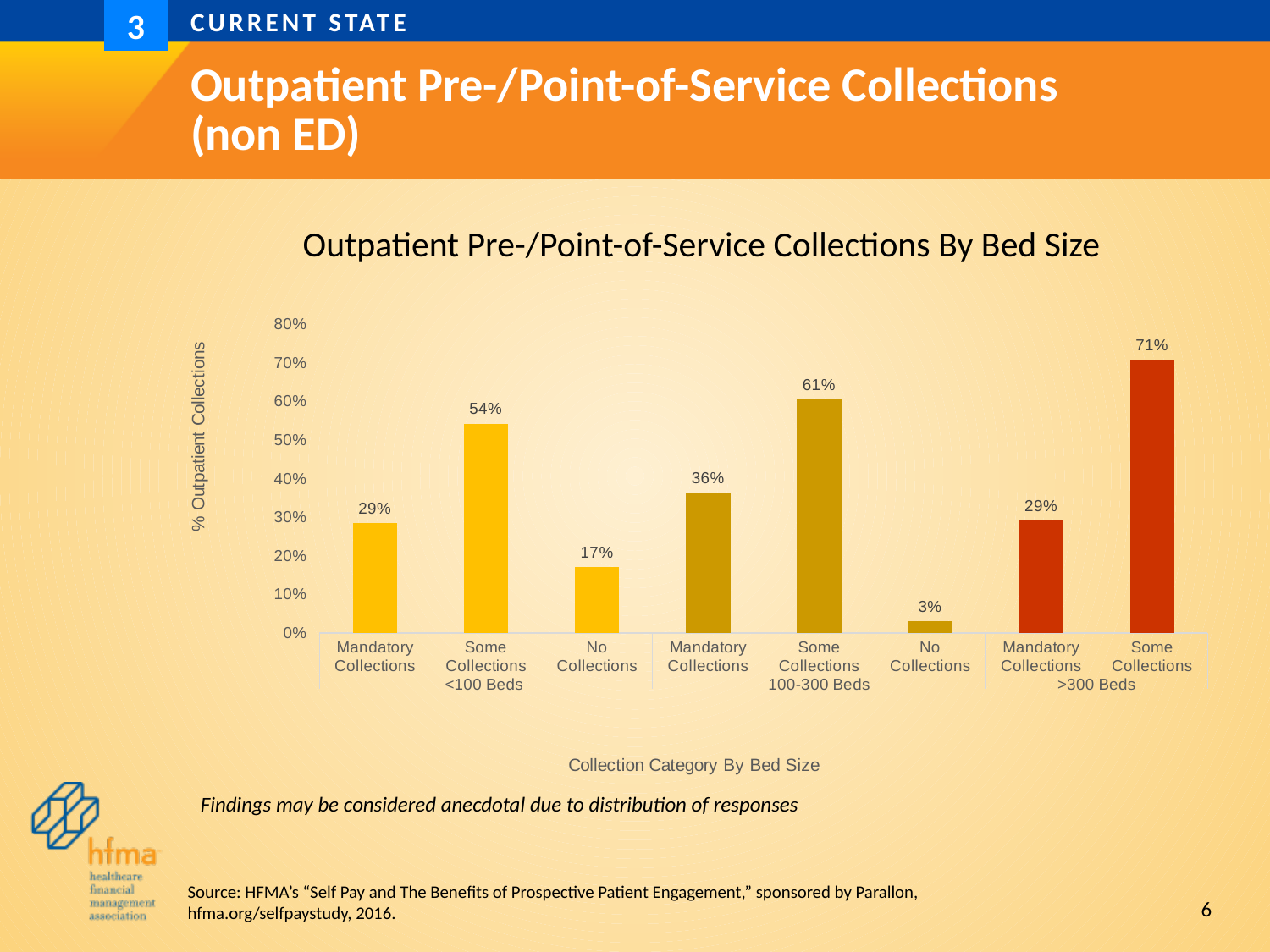
What is the value for Some Collections in the <100 Beds group? 54% Which is larger: Mandatory Collections for <100 Beds or Mandatory Collections for 100-300 Beds? Mandatory Collections for 100-300 Beds What is the difference between Some Collections for >300 Beds and Some Collections for <100 Beds? 17% Which bar has the highest value in the chart? Some Collections, >300 Beds What is the title of the chart? Outpatient Pre-/Point-of-Service Collections By Bed Size What type of chart is shown on the slide? Bar chart What is the value for Mandatory Collections in the >300 Beds group? 29% How many bars are plotted in the chart? 8 What is the value for No Collections in the 100-300 Beds group? 3% Which bar has the lowest value in the chart? No Collections, 100-300 Beds What is the difference between Some Collections and Mandatory Collections in the 100-300 Beds group? 25% Is the value for No Collections in the <100 Beds group greater or less than 20%? less